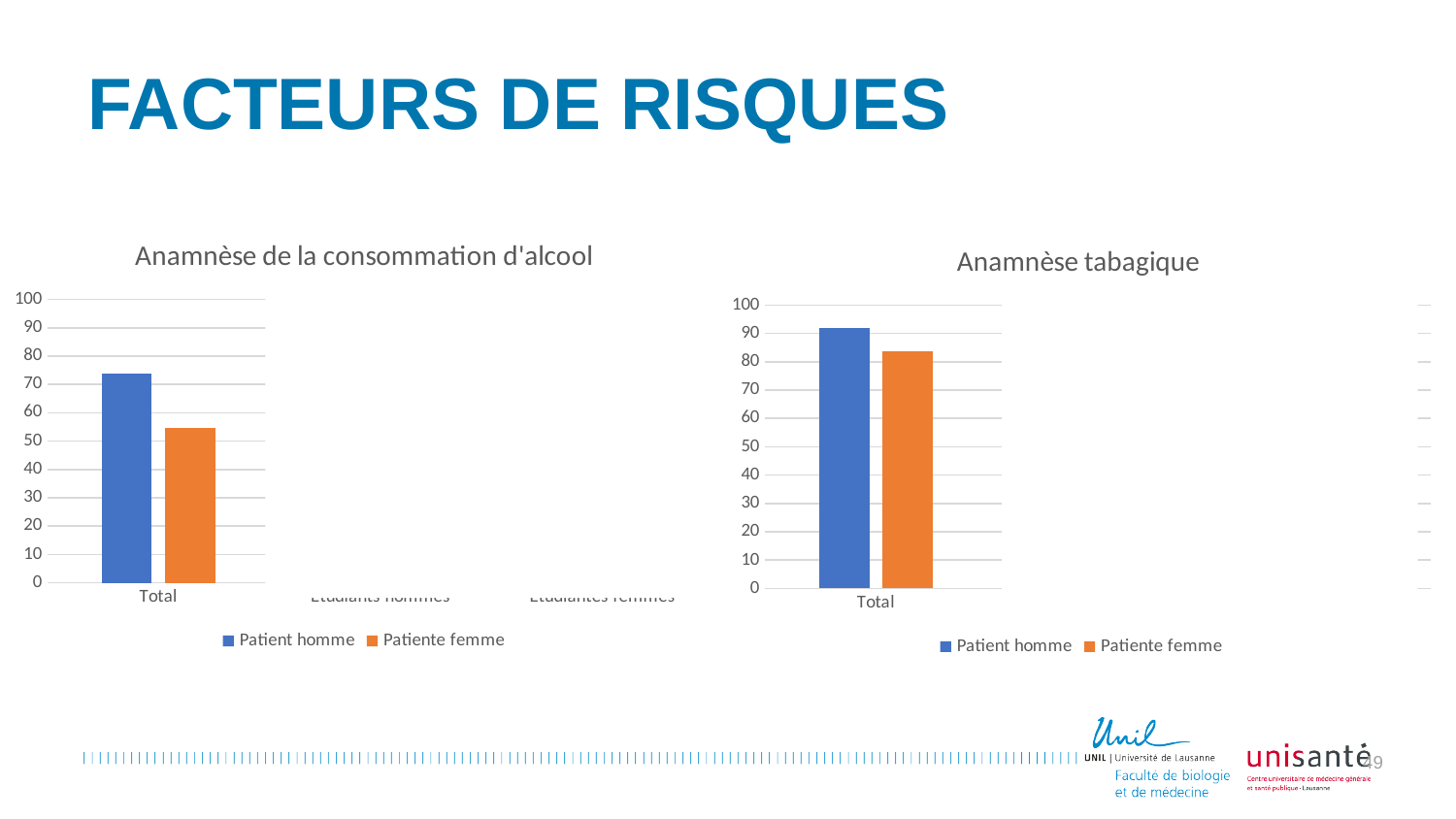
What kind of chart is the 'Anamnèse de la consommation d'alcool' chart? bar chart In the 'Anamnèse tabagique' chart, which colour represents the Patiente femme series? orange In the 'Anamnèse tabagique' chart, is the value for Patiente femme (Total) greater or less than 80? greater What is the title of the chart on the right side of the slide? Anamnèse tabagique In the 'Anamnèse tabagique' chart, how many series does the legend list? 2 In the 'Anamnèse de la consommation d'alcool' chart, how many series does the legend list? 2 In the 'Anamnèse de la consommation d'alcool' chart, is the value for Patient homme (Total) greater or less than 70? greater In the 'Anamnèse tabagique' chart, is the value for Patient homme (Total) greater or less than 90? greater In the 'Anamnèse de la consommation d'alcool' chart, which series has the larger value for Total, Patient homme or Patiente femme? Patient homme What kind of chart is the 'Anamnèse tabagique' chart? bar chart In the 'Anamnèse tabagique' chart, which series has the larger value for Total, Patient homme or Patiente femme? Patient homme